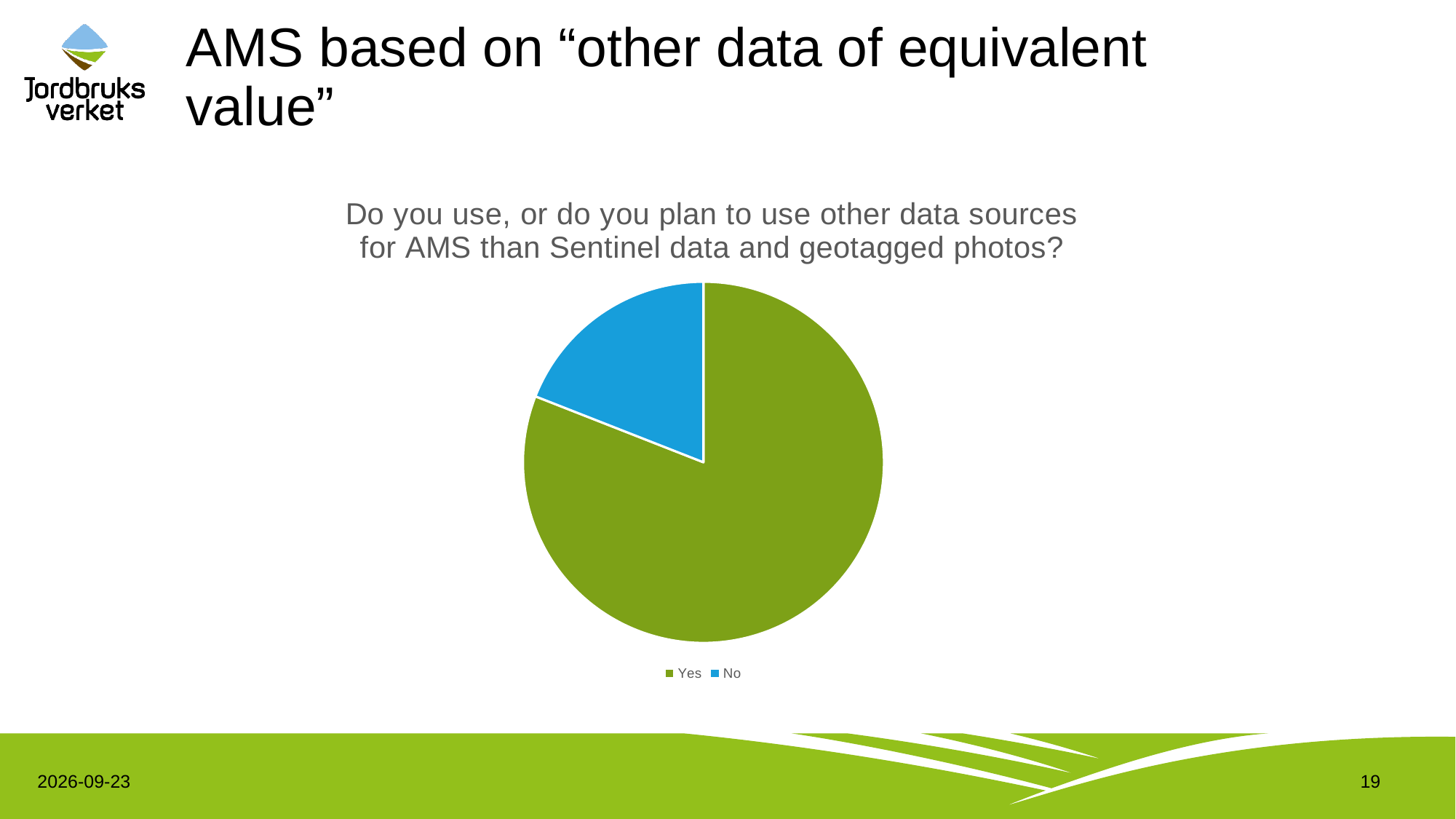
Which category has the largest slice in the pie chart? Yes What is the title of the pie chart? Do you use, or do you plan to use other data sources for AMS than Sentinel data and geotagged photos? What colour is the Yes slice in the pie chart? green What kind of chart is shown on the slide? pie chart How many slices does the pie chart have? 2 How many entries does the legend of the pie chart list? 2 Which slice is larger in the pie chart, Yes or No? Yes Which category has the smallest slice in the pie chart? No